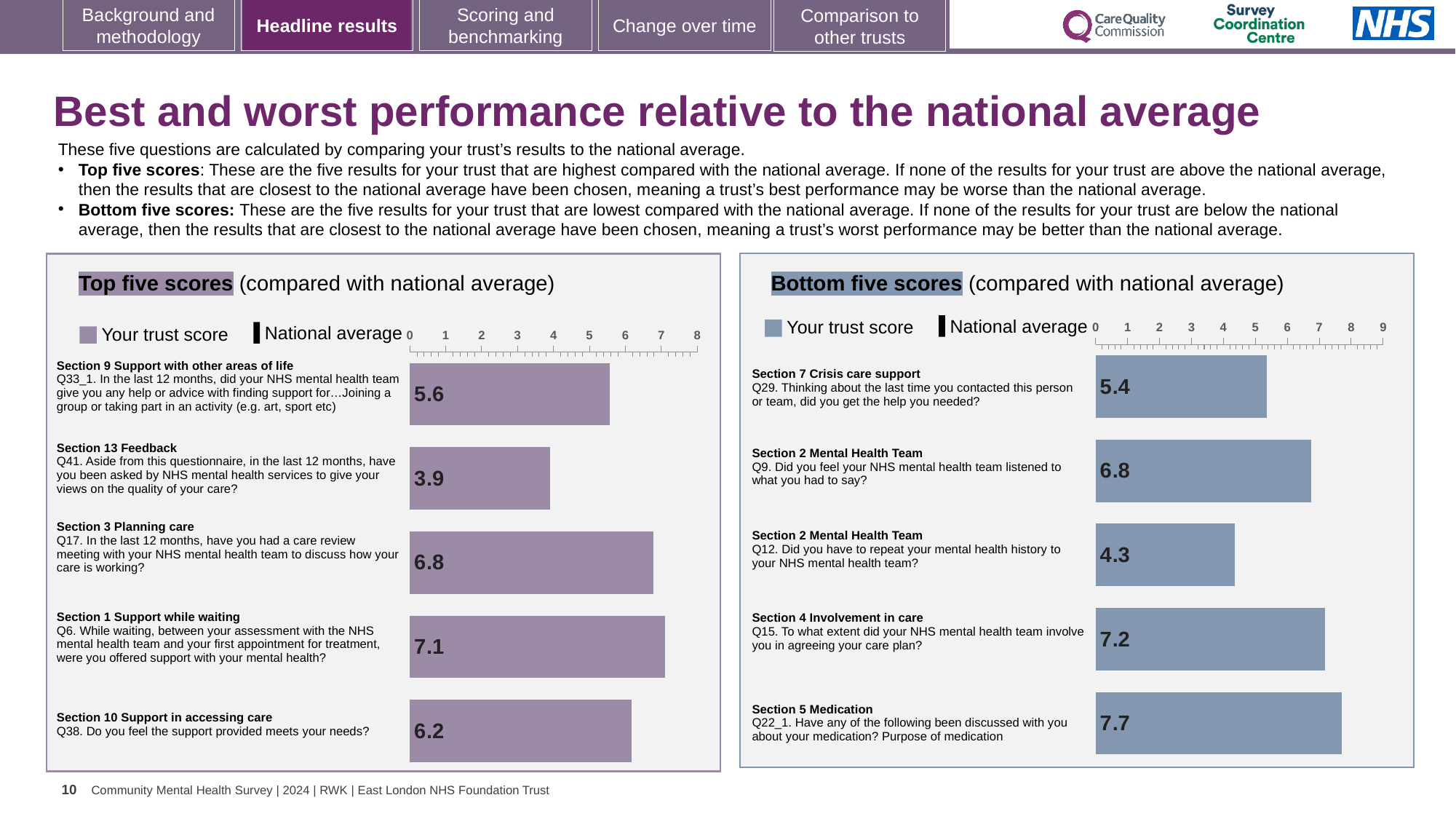
In the Bottom five scores chart, what is the trust score for Q22_1 (Section 5 Medication)? 7.7 In the Bottom five scores chart, which question has the lowest trust score? Q12 (Section 2 Mental Health Team) In the Top five scores chart, what is the difference between the trust scores for Q17 and Q38? 0.6 In the Top five scores chart, what is the trust score for Q6 (Section 1 Support while waiting)? 7.1 How many bars are shown in the Bottom five scores chart? 5 In the Top five scores chart, which question has the highest trust score? Q6 (Section 1 Support while waiting) What type of chart is the Top five scores chart? Bar chart In the Top five scores chart, what is the trust score for Q41 (Section 13 Feedback)? 3.9 In the Bottom five scores chart, what is the difference between the trust scores for Q22_1 and Q15? 0.5 How many entries does the legend of the Top five scores chart list? 2 In the Bottom five scores chart, what is the trust score for Q12 (Section 2 Mental Health Team)? 4.3 In the Bottom five scores chart, which has the larger trust score, Q29 or Q9? Q9